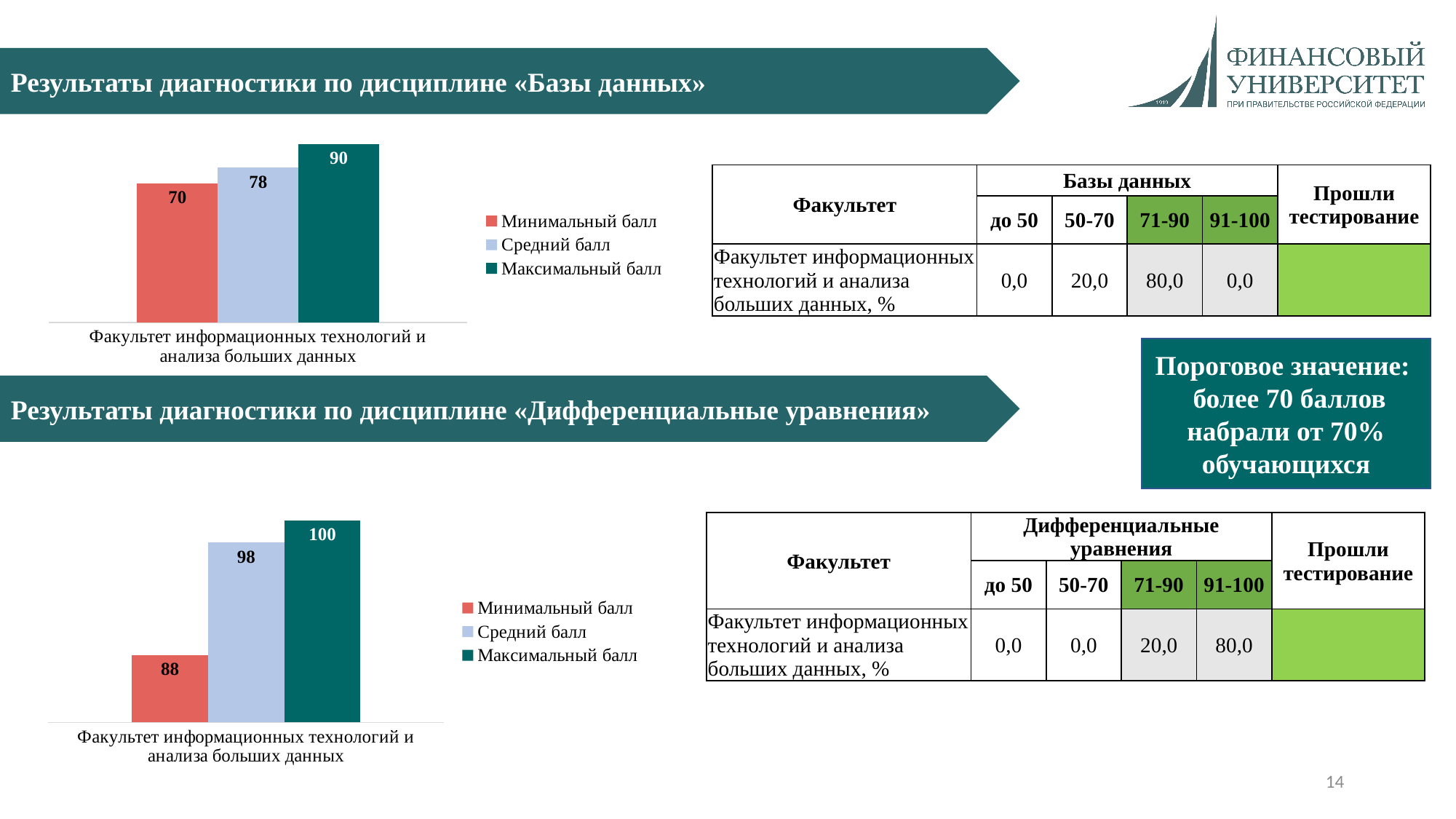
How many series does the legend of the top chart (Базы данных) list? 3 In the top chart (Базы данных), which series has the highest value? Максимальный балл In the top chart (Базы данных), what is the value for Средний балл? 78 In the top chart (Базы данных), what is the value for Минимальный балл? 70 In the bottom chart (Дифференциальные уравнения), what is the value for Максимальный балл? 100 In the top chart (Базы данных), what is the difference between Максимальный балл and Минимальный балл? 20 In the top chart (Базы данных), what is the value for Максимальный балл? 90 Which is larger: Средний балл in the top chart (Базы данных) or Средний балл in the bottom chart (Дифференциальные уравнения)? Bottom chart (Дифференциальные уравнения) In the bottom chart (Дифференциальные уравнения), what is the value for Минимальный балл? 88 In the bottom chart (Дифференциальные уравнения), which series has the lowest value? Минимальный балл What type of chart is the bottom chart (Дифференциальные уравнения)? Bar chart In the bottom chart (Дифференциальные уравнения), what is the difference between Средний балл and Минимальный балл? 10